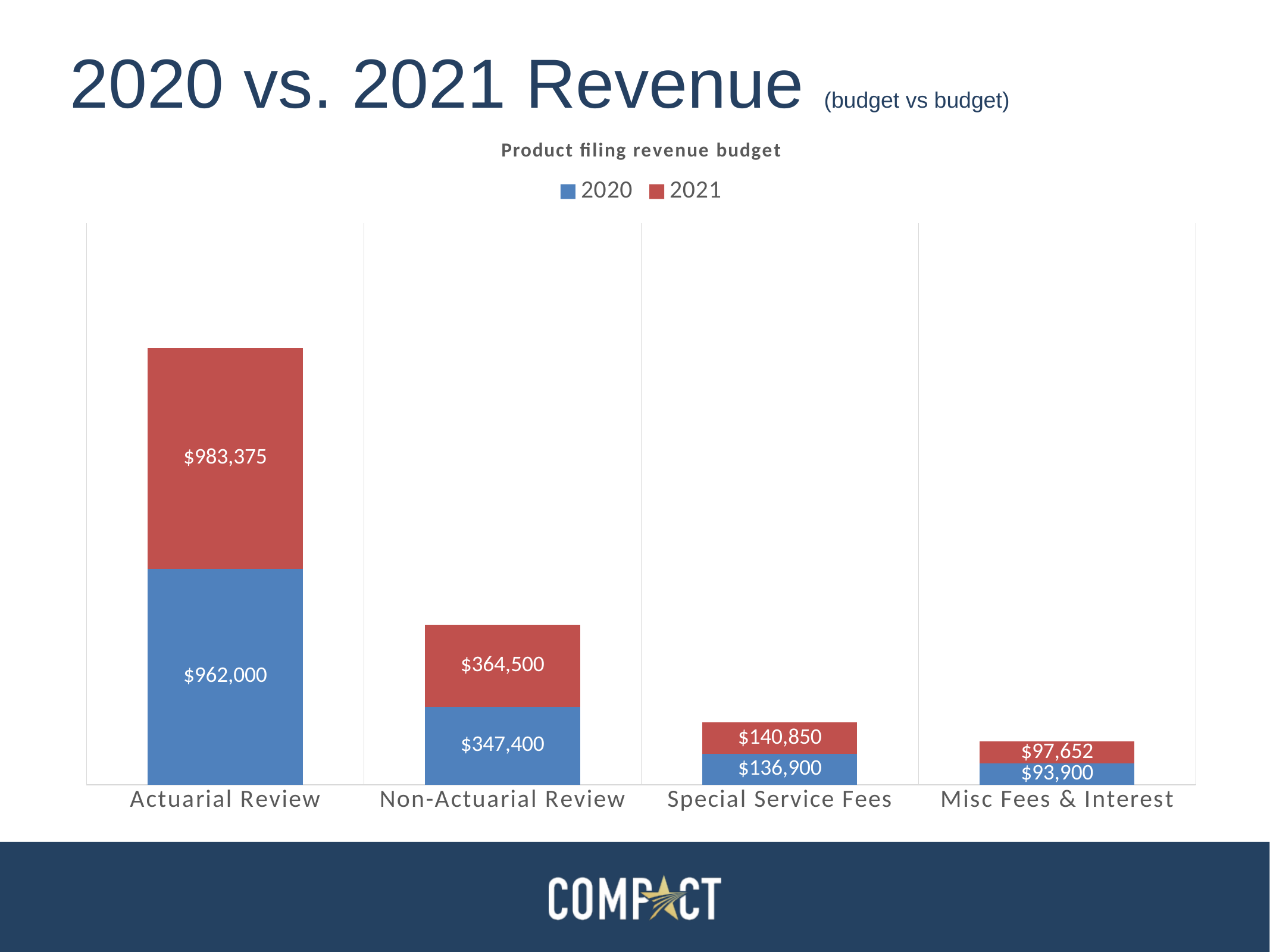
What is the 2020 value for Special Service Fees? $136,900 What is the total of the stacked bar for Special Service Fees? $277,750 Which is larger, the 2021 value for Non-Actuarial Review or the 2021 value for Special Service Fees? Non-Actuarial Review What is the 2021 value for Misc Fees & Interest? $97,652 What kind of chart is shown? Stacked bar chart What is the 2021 value for Non-Actuarial Review? $364,500 What is the 2020 value for Actuarial Review? $962,000 Which category has the lowest 2020 value? Misc Fees & Interest Which category has the highest 2021 value? Actuarial Review What is the difference between the 2021 and 2020 values for Actuarial Review? $21,375 How many categories are shown on the x axis? 4 How many series does the legend list? 2